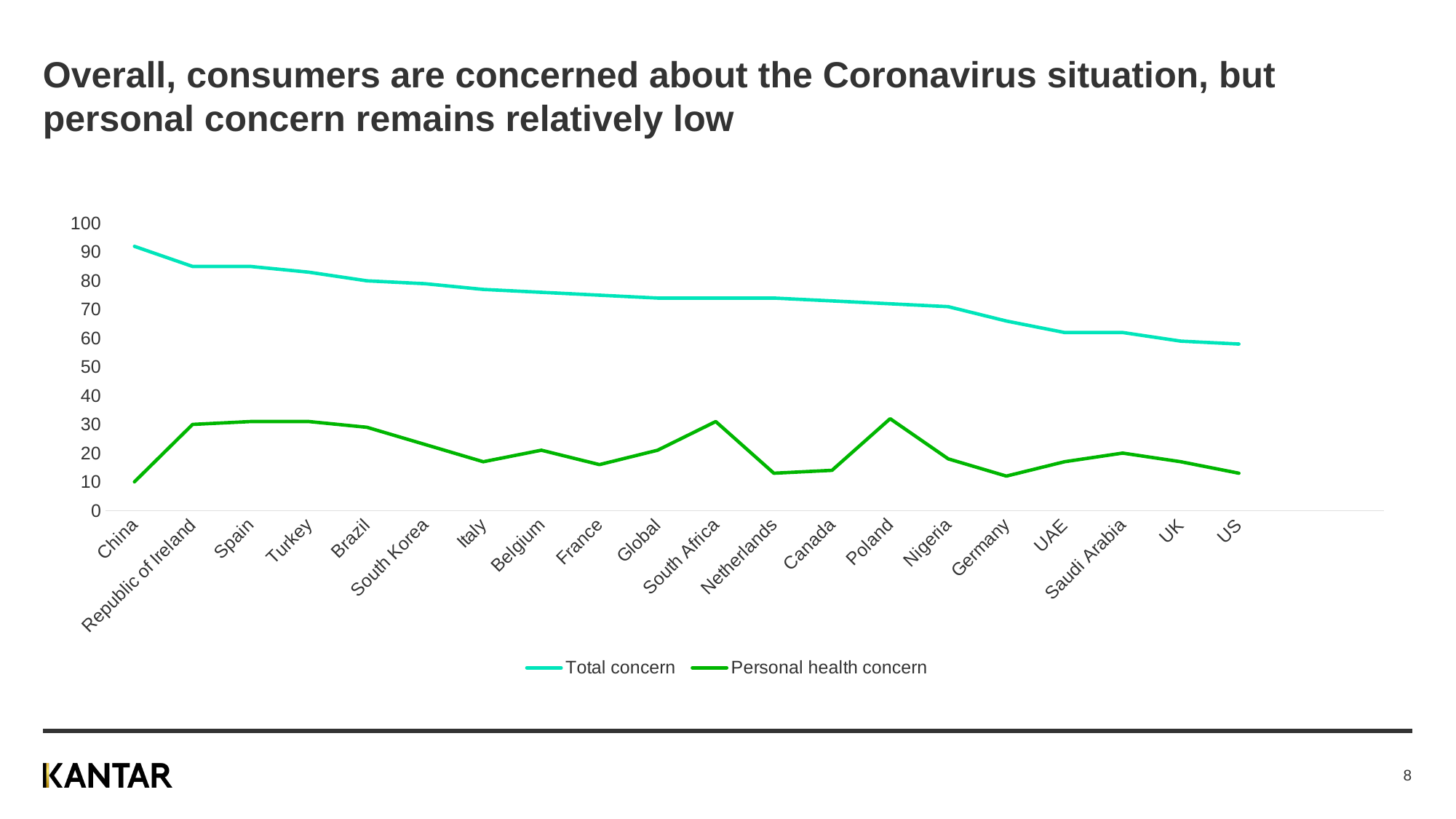
Which category has the highest Total concern value? China What kind of chart is shown on the slide? Line chart Is the Total concern value for UAE greater or less than 70? less Is the Personal health concern value for Spain greater or less than 20? greater Which category has the lowest Total concern value? US How many series does the legend list? 2 How many countries/categories are plotted along the x axis? 20 Which is larger, the Total concern value for Spain or for UK? Spain Does the Total concern line generally rise or fall from China to US along the x axis? Fall Is the Personal health concern value for Netherlands greater or less than 20? less What are the two series named in the legend? Total concern and Personal health concern